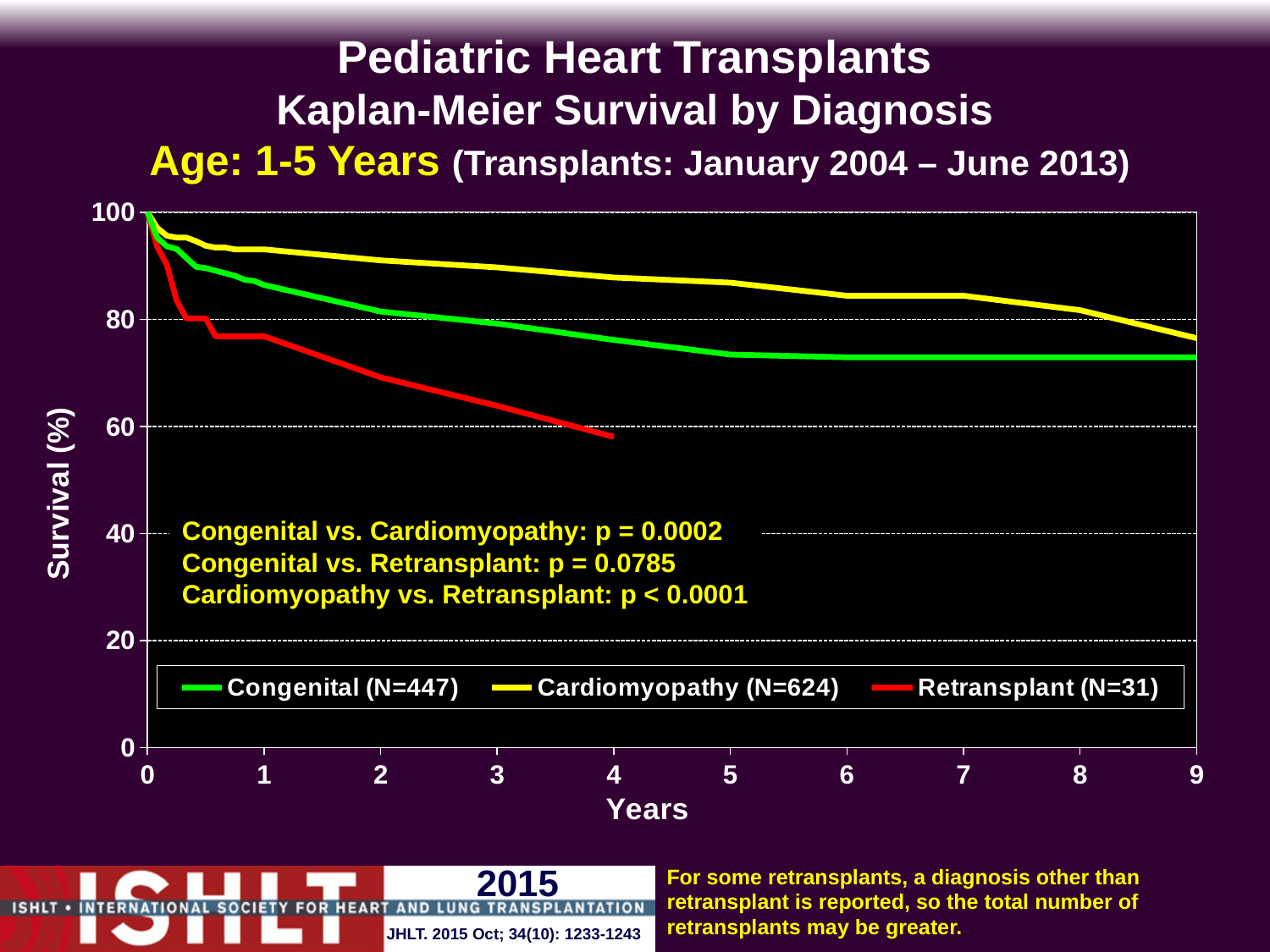
Is the survival for Congenital at 5 years greater or less than 80%? less How many series does the legend list? 3 Is the survival for Retransplant at 4 years greater or less than 60%? less Which diagnosis group has the highest survival at 5 years? Cardiomyopathy What kind of chart is shown on the slide? Line chart Do the survival curves rise or fall as years increase? Fall Is the survival for Retransplant at 2 years greater or less than 60%? greater What is the N for the Retransplant group shown in the legend? N=31 At 3 years, which group has higher survival: Congenital or Cardiomyopathy? Cardiomyopathy Which diagnosis group has the lowest survival at 3 years? Retransplant What p-value is shown for Cardiomyopathy vs. Retransplant? p < 0.0001